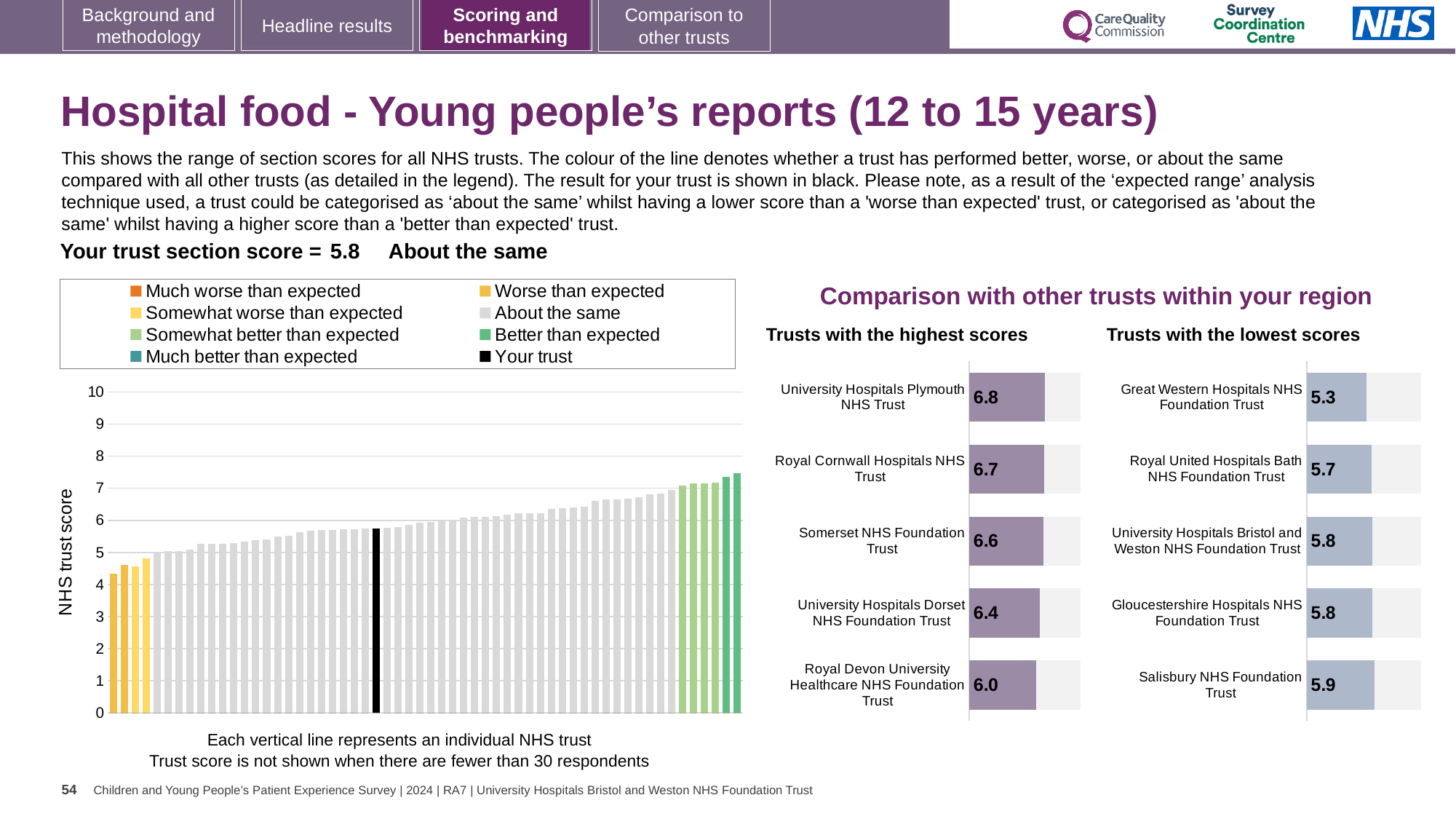
In the 'Trusts with the highest scores' chart, what is the difference between the scores of University Hospitals Plymouth NHS Trust and Royal Devon University Healthcare NHS Foundation Trust? 0.8 In the NHS trust score chart on the left, is the value of the black 'Your trust' bar greater or less than 5? greater In the 'Trusts with the highest scores' chart, what is the score for University Hospitals Plymouth NHS Trust? 6.8 How many trusts are shown in the 'Trusts with the highest scores' chart? 5 In the 'Trusts with the lowest scores' chart, what is the score for Great Western Hospitals NHS Foundation Trust? 5.3 In the 'Trusts with the highest scores' chart, which trust has the highest score? University Hospitals Plymouth NHS Trust Comparing the two regional charts, which has the higher score: Somerset NHS Foundation Trust or Royal United Hospitals Bath NHS Foundation Trust? Somerset NHS Foundation Trust In the 'Trusts with the lowest scores' chart, what is the score for Salisbury NHS Foundation Trust? 5.9 In the 'Trusts with the lowest scores' chart, which trust has the lowest score? Great Western Hospitals NHS Foundation Trust In the NHS trust score chart on the left, do the bar values rise or fall from left to right? Rise What kind of chart is the NHS trust score chart on the left? Bar chart How many entries does the legend of the NHS trust score chart list? 8